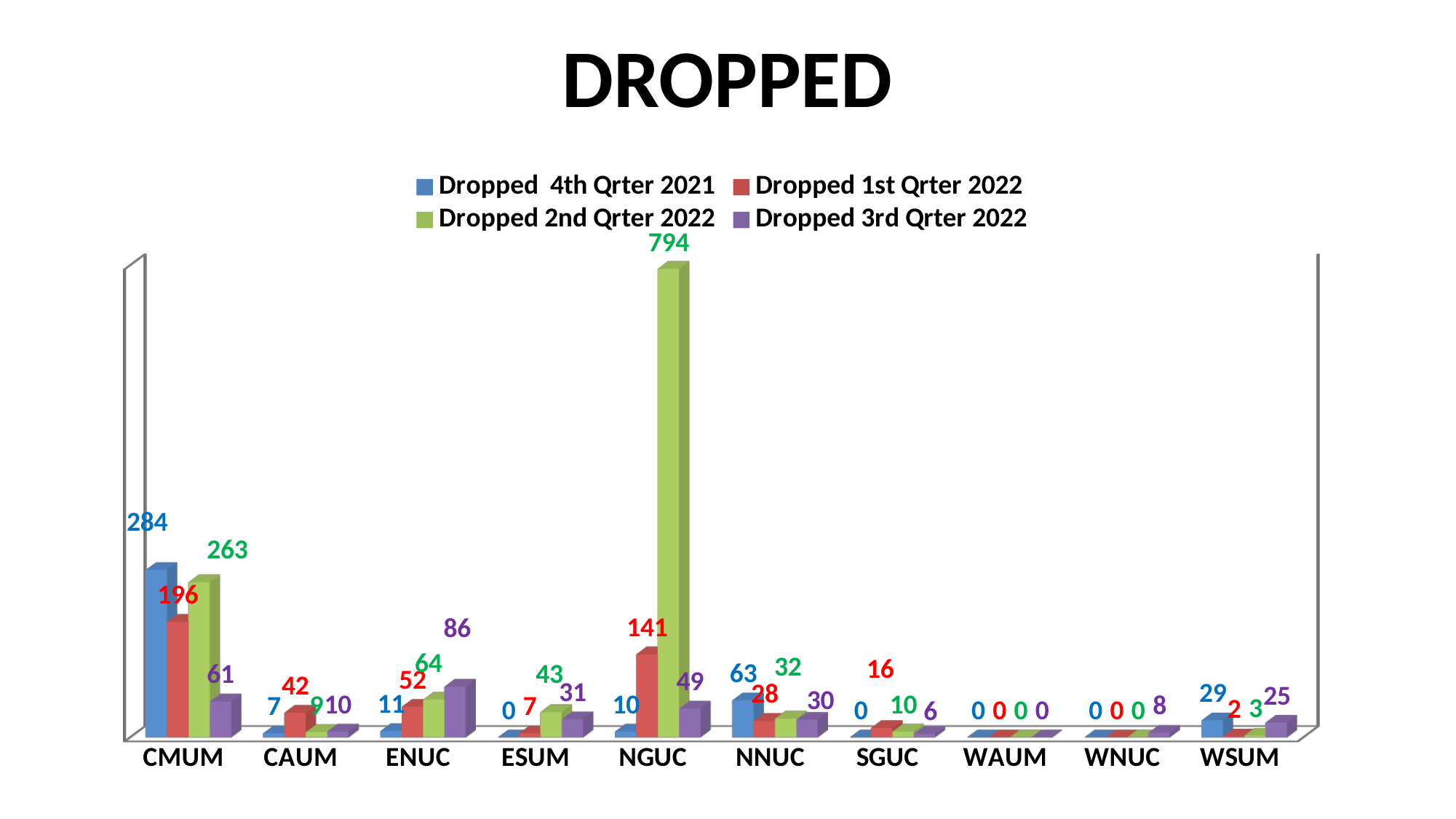
Which category has the highest value in the Dropped 1st Qrter 2022 series? CMUM Which category has the highest value in the Dropped 2nd Qrter 2022 series? NGUC What is the difference between the Dropped 4th Qrter 2021 and Dropped 2nd Qrter 2022 values for CMUM? 21 What is the value for CMUM in the Dropped 4th Qrter 2021 series? 284 What kind of chart is shown on the slide? Bar chart Which is larger for NNUC: the Dropped 4th Qrter 2021 value or the Dropped 2nd Qrter 2022 value? Dropped 4th Qrter 2021 How many categories are shown on the x axis? 10 How many series does the legend list? 4 What is the title of the chart? DROPPED What is the value for NGUC in the Dropped 2nd Qrter 2022 series? 794 What is the value for WSUM in the Dropped 1st Qrter 2022 series? 2 What is the value for ENUC in the Dropped 3rd Qrter 2022 series? 86